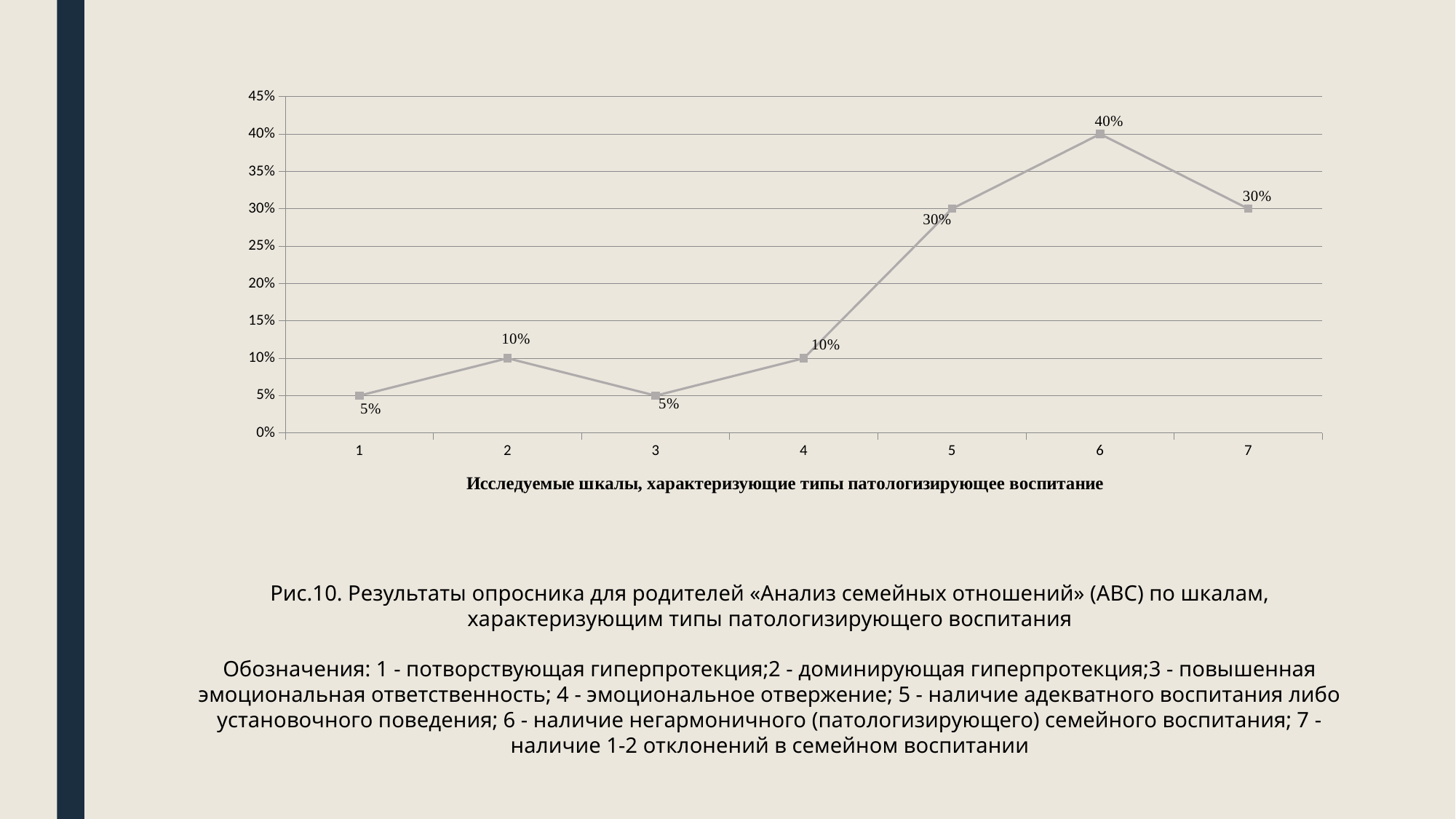
How many points are plotted on the line? 7 What is the value for scale 4? 10% What is the difference between the values for scale 6 and scale 5? 10% What is the difference between the values for scale 2 and scale 3? 5% What is the x-axis title of the chart? Исследуемые шкалы, характеризующие типы патологизирующее воспитание Which scale has the highest value? 6 Do the values rise or fall from scale 4 to scale 6? rise What is the value for scale 7? 30% What type of chart is shown on the slide? line chart What is the value for scale 6? 40% Which is larger, the value for scale 5 or the value for scale 4? scale 5 What is the value for scale 1? 5%